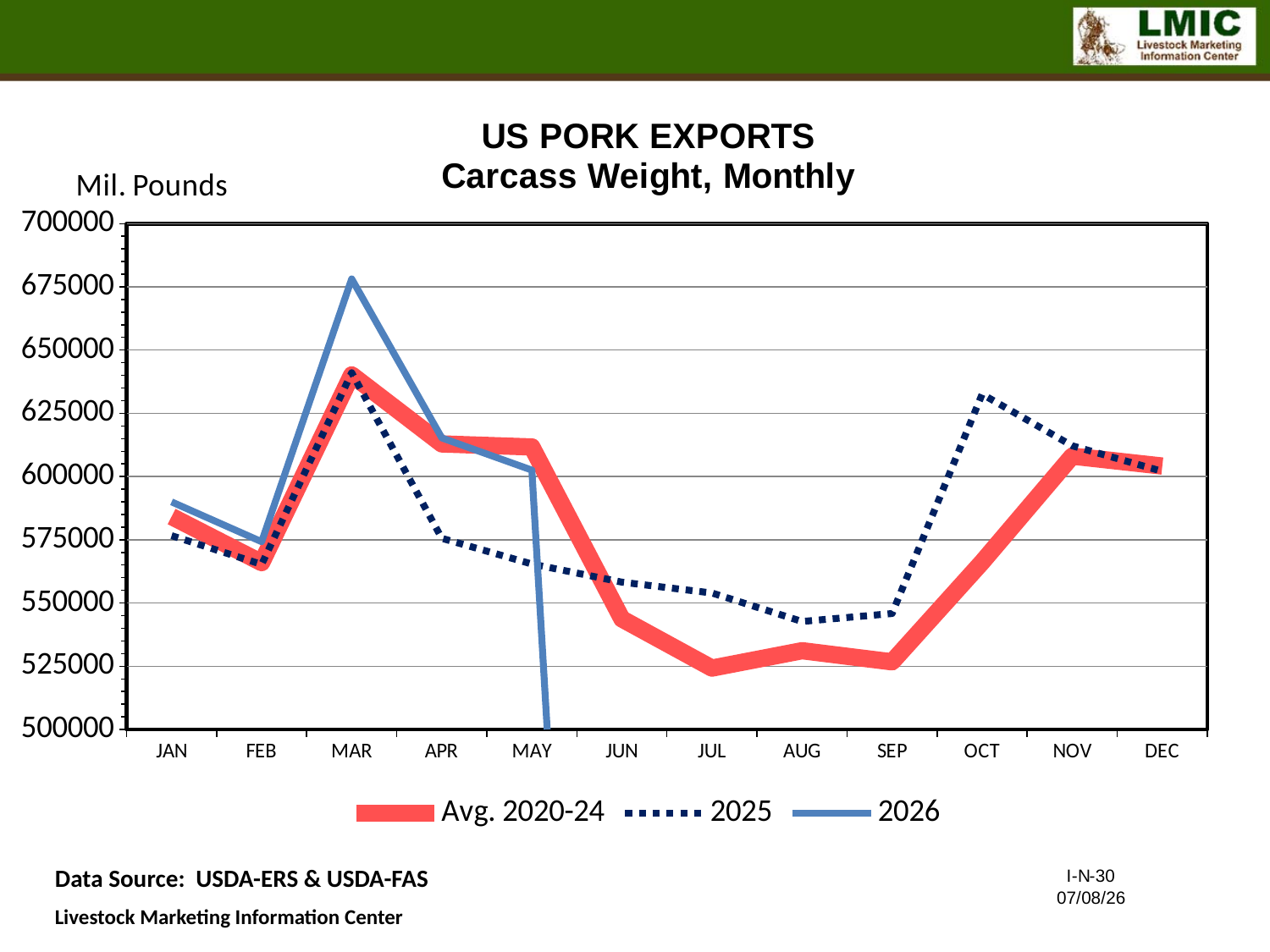
What unit label is shown above the y axis? Mil. Pounds What kind of chart is shown on the slide? line chart Is the 2026 value for MAR greater or less than 650000? greater Is the 2025 value for APR greater or less than 600000? less How many months are shown along the x axis? 12 Is the Avg. 2020-24 value for AUG greater or less than 550000? less In JUL, which is larger: the 2025 value or the Avg. 2020-24 value? 2025 Does the 2025 series rise or fall from MAR to AUG? fall In MAR, which is larger: the 2026 value or the Avg. 2020-24 value? 2026 In which month does the 2026 series reach its highest value? MAR How many series does the legend list? 3